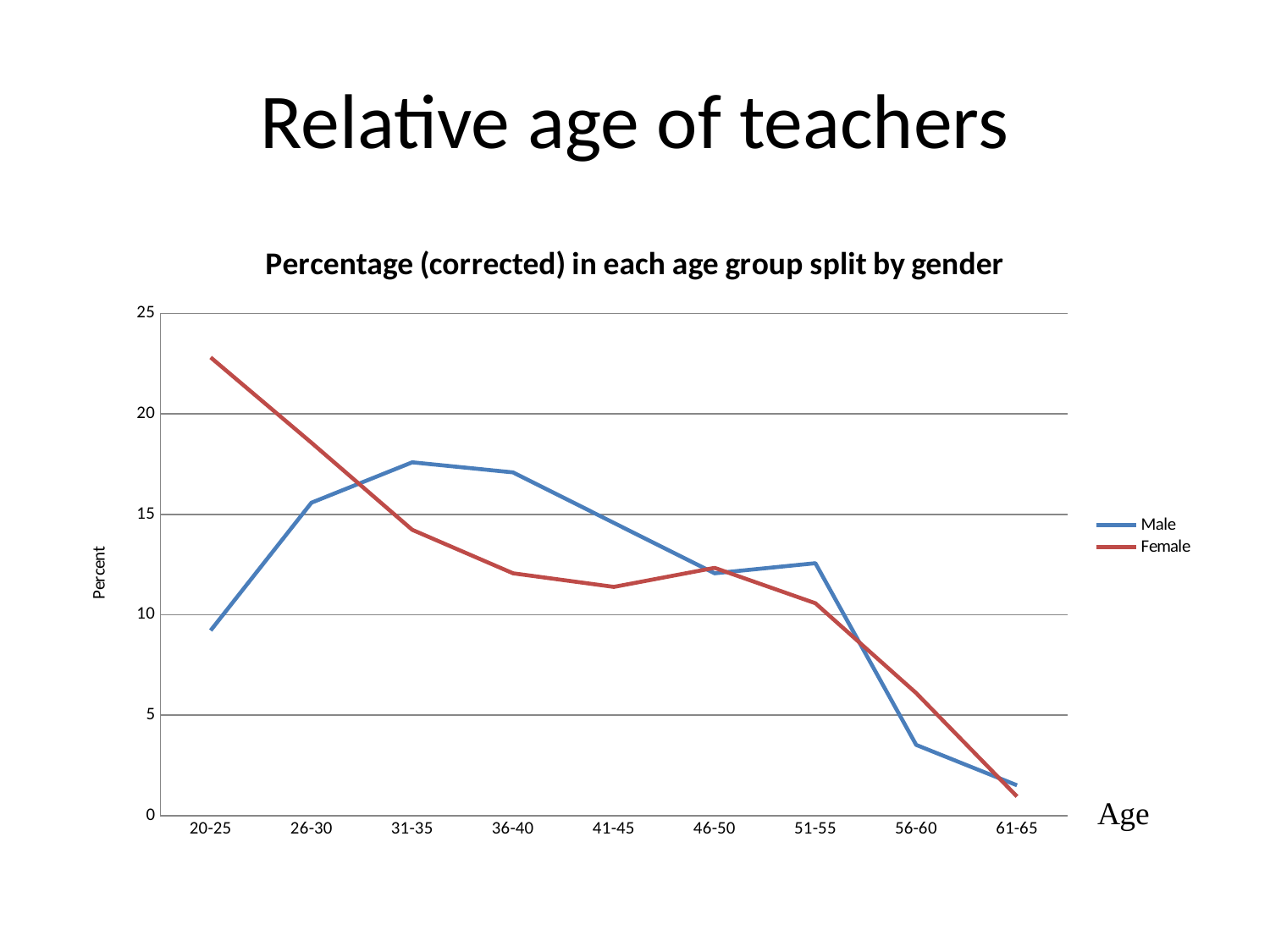
In the 20-25 age group, which series has the larger value, Male or Female? Female Is the Male value for the 20-25 age group greater or less than 10? less What kind of chart is shown on the slide? Line chart Which age group has the lowest value for the Female series? 61-65 Is the Male value for the 56-60 age group greater or less than 5? less How many series does the legend list? 2 Is the Female value for the 20-25 age group greater or less than 20? greater Which age group has the lowest value for the Male series? 61-65 What is the title of the chart? Percentage (corrected) in each age group split by gender In the 31-35 age group, which series has the larger value, Male or Female? Male How many age groups are shown on the x axis? 9 Which age group has the highest value for the Female series? 20-25